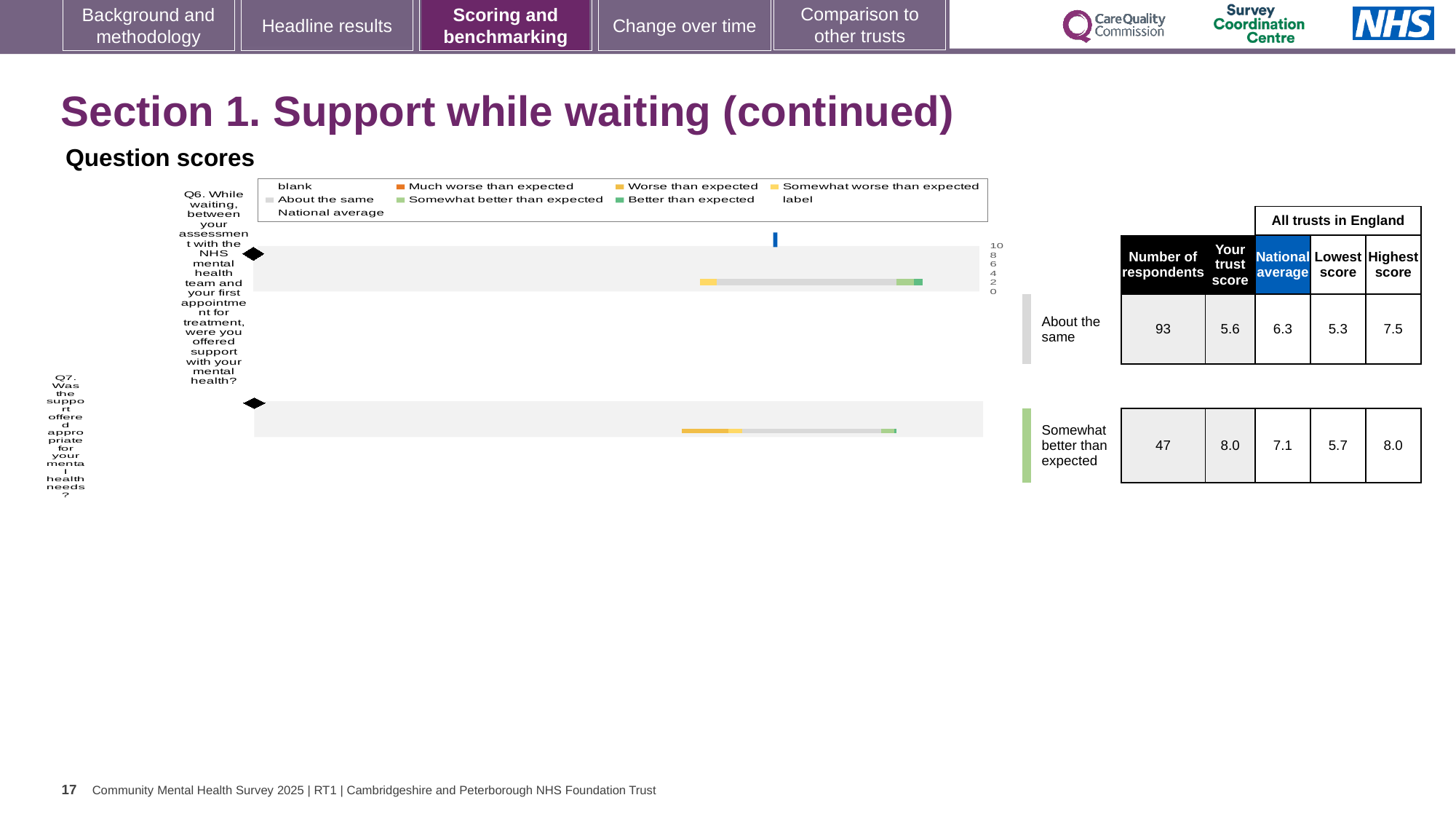
What is the national average score for Q7? 7.1 By how much does the trust score for Q7 exceed the national average for Q7? 0.9 Which benchmarking category is the trust's Q7 score placed in? Somewhat better than expected What is the highest score among all trusts in England for Q7? 8.0 For Q6, which is larger: the trust score or the national average? National average What is the lowest score among all trusts in England for Q6? 5.3 How many respondents answered Q6? 93 What is the trust score for Q7 (was the support offered appropriate for your mental health needs)? 8.0 What is the trust score for Q6 (support with mental health while waiting)? 5.6 What is the difference between the highest and lowest scores for Q6 across all trusts in England? 2.2 Which question has the higher trust score, Q6 or Q7? Q7 How many questions are plotted on the chart? 2